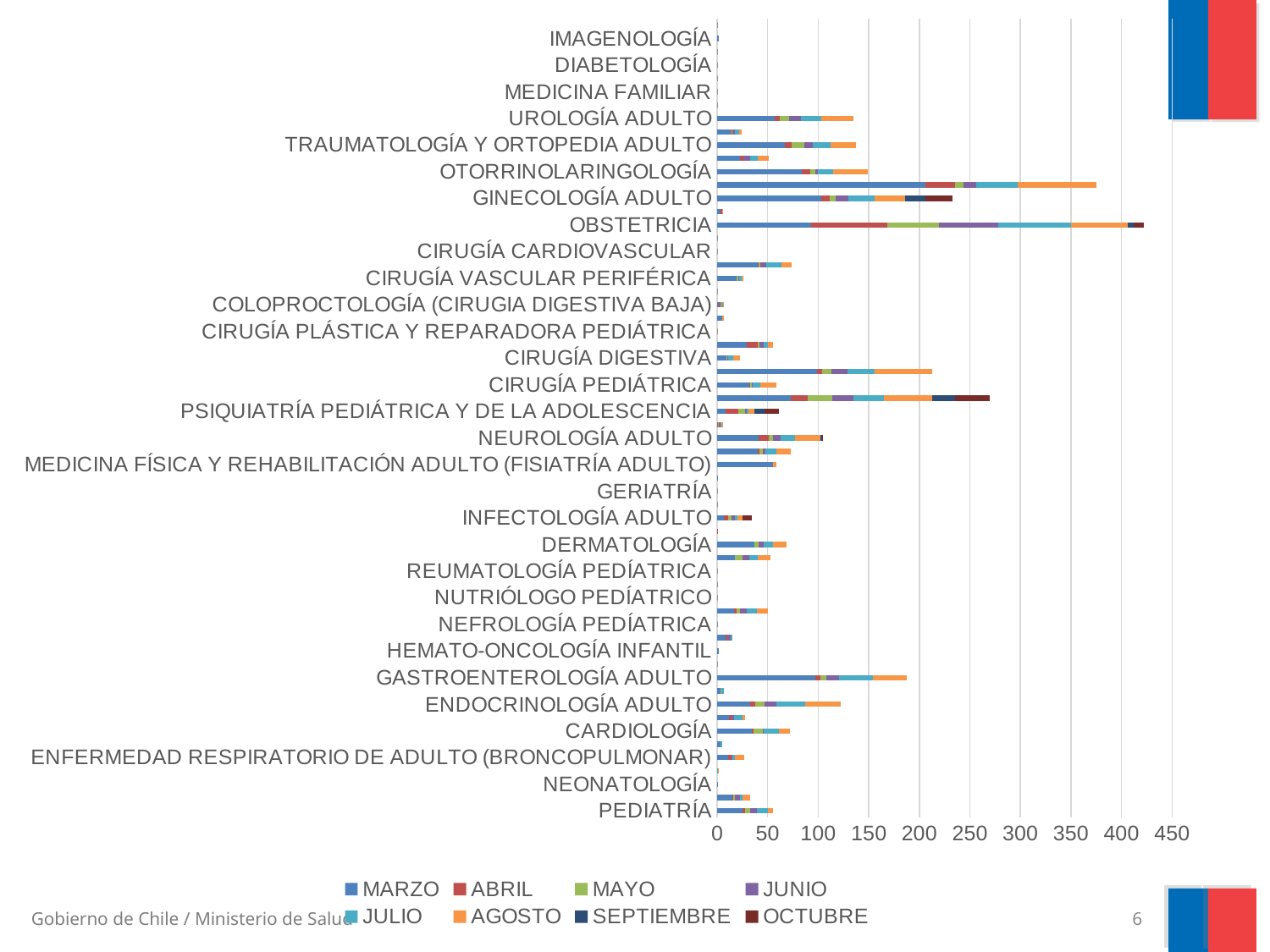
Which category has the longest bar? OBSTETRICIA Is the total value for ENDOCRINOLOGÍA ADULTO greater or less than 100? greater Is the total value for CIRUGÍA VASCULAR PERIFÉRICA greater or less than 50? less Is the total value for GASTROENTEROLOGÍA ADULTO greater or less than 150? greater Which month is the first entry in the legend? MARZO Which has the larger total, OBSTETRICIA or GINECOLOGÍA ADULTO? OBSTETRICIA How many series does the legend list? 8 What kind of chart is shown on the slide? bar chart Which has the larger total, GASTROENTEROLOGÍA ADULTO or CARDIOLOGÍA? GASTROENTEROLOGÍA ADULTO